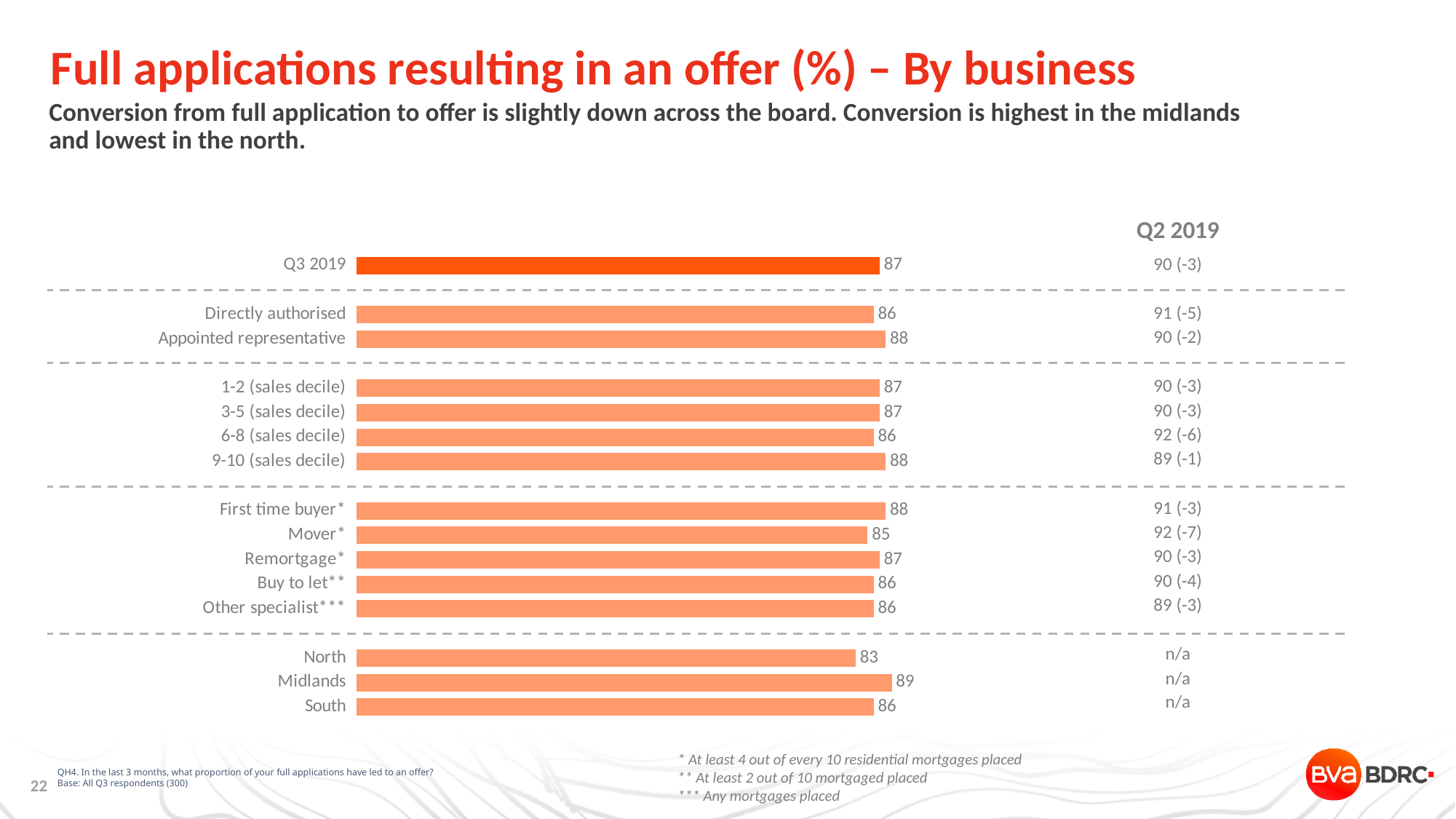
Which is larger, the value for First time buyer or the value for Mover? First time buyer How many bars are plotted in the chart? 15 What is the value for Appointed representative? 88 What is the value for North? 83 What kind of chart is shown on the slide? Bar chart What is the value for Mover? 85 What is the value for Midlands? 89 Which category has the highest value? Midlands What is the difference between the values for Midlands and North? 6 Which category has the lowest value? North What is the Q3 2019 overall value shown at the top of the chart? 87 What Q2 2019 value is listed for Directly authorised? 91 (-5)